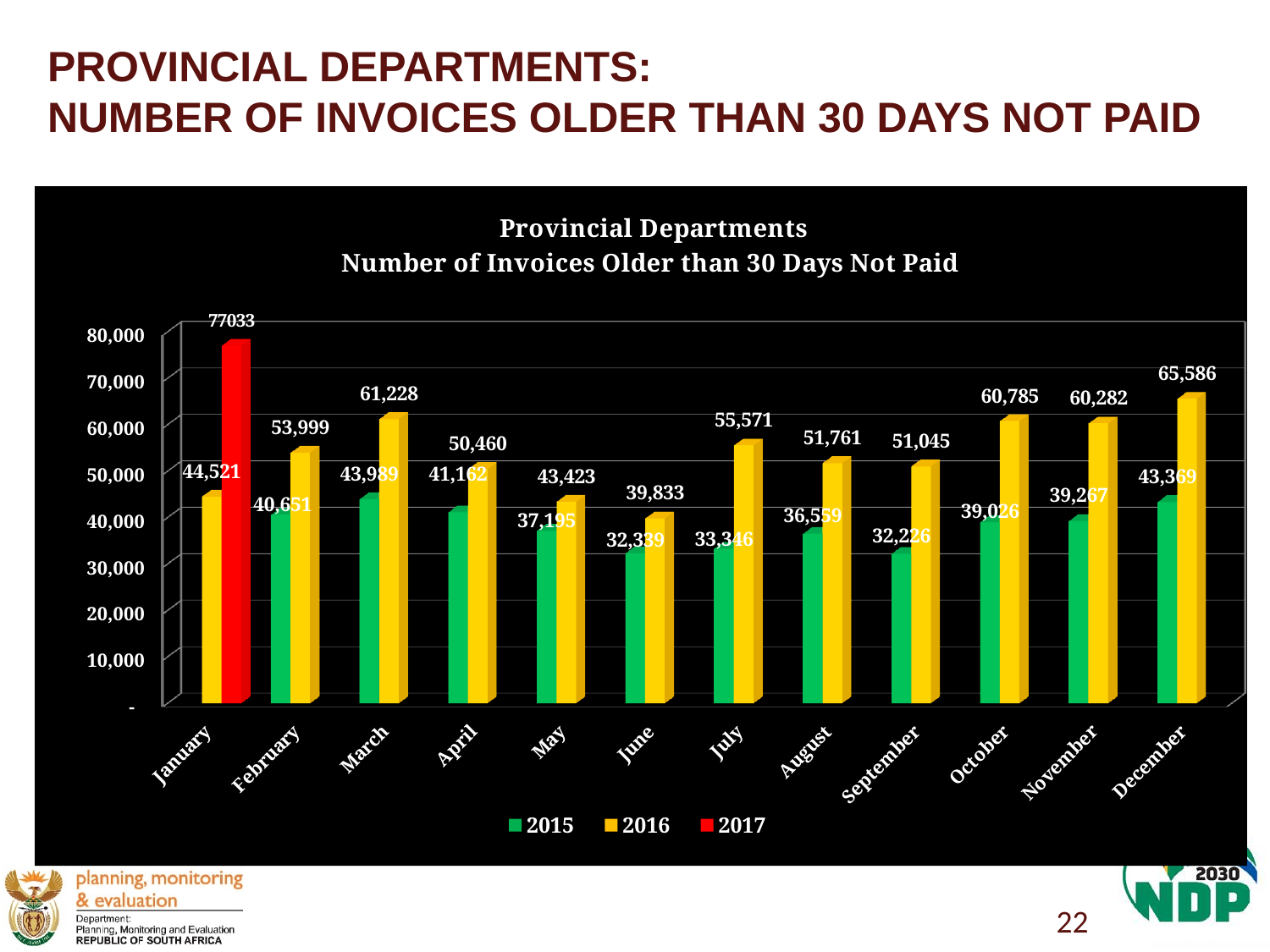
How many series does the legend list? 3 Is the 2015 value for February greater or less than 50,000? less What is the difference between the 2016 values for December and January? 21,065 Do the 2016 values rise or fall from April to June? fall Which month has the lowest value for the 2016 series? June What kind of chart is shown on the slide? bar chart What is the value for 2017 in January? 77033 Which is larger, the 2016 value for July or the 2016 value for August? July Which month has the highest value for the 2016 series? December How many months are shown on the x axis? 12 What is the value for 2016 in August? 51,761 What is the value for 2016 in March? 61,228